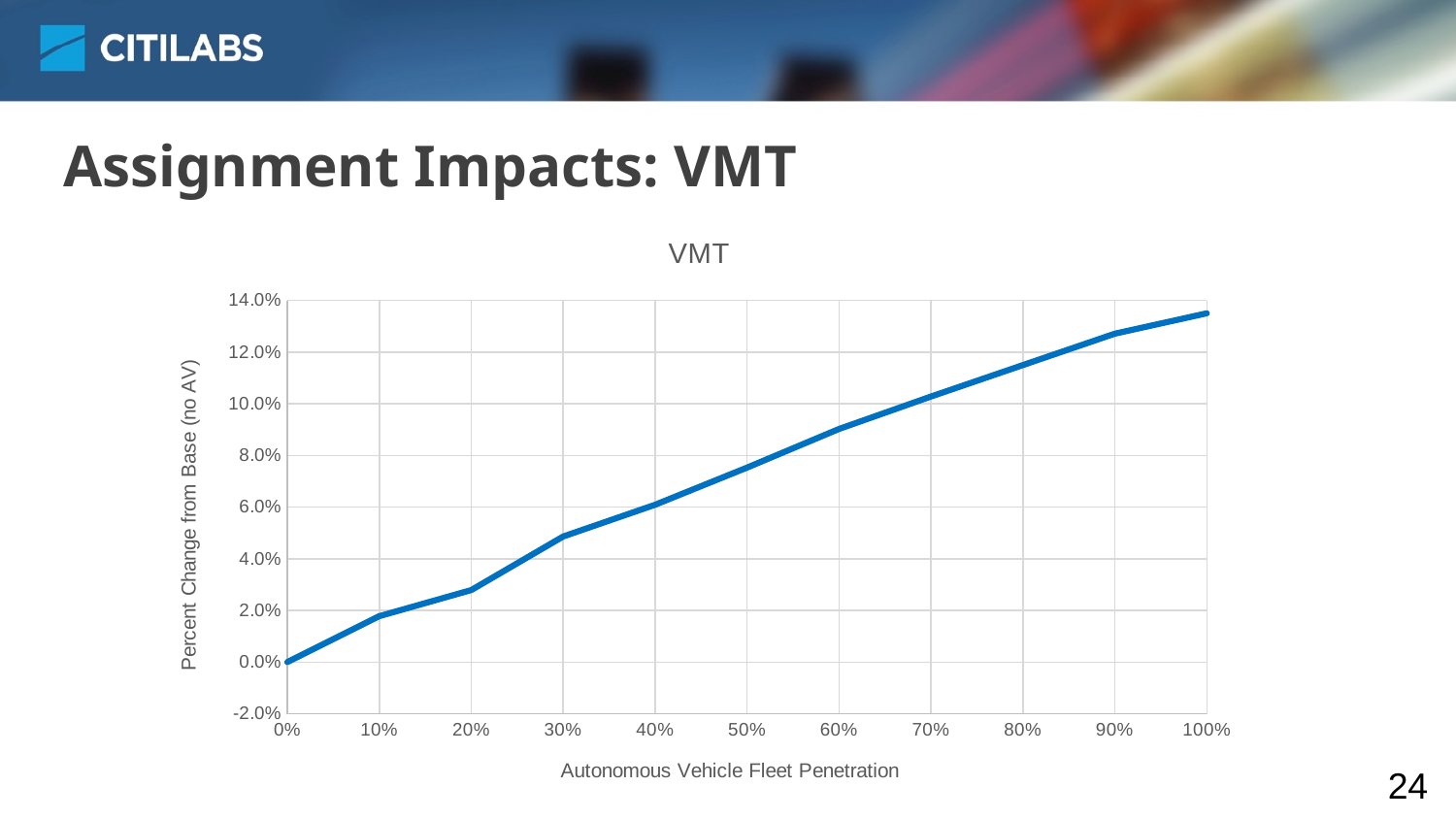
Which has a larger percent change from base: 30% or 70% fleet penetration? 70% At which fleet penetration level is the percent change from base lowest? 0% Do the values rise or fall as autonomous vehicle fleet penetration increases from 0% to 100%? rise Is the percent change from base at 100% fleet penetration greater or less than 14.0%? less What kind of chart is shown on the slide? line chart At which fleet penetration level is the percent change from base highest? 100% Is the percent change from base at 50% fleet penetration greater or less than 6.0%? greater What is the percent change from base at 0% autonomous vehicle fleet penetration? 0.0% What is the title of the chart? VMT What is the label of the x axis? Autonomous Vehicle Fleet Penetration Is the percent change from base at 20% fleet penetration greater or less than 4.0%? less How many fleet penetration levels are marked on the x axis? 11